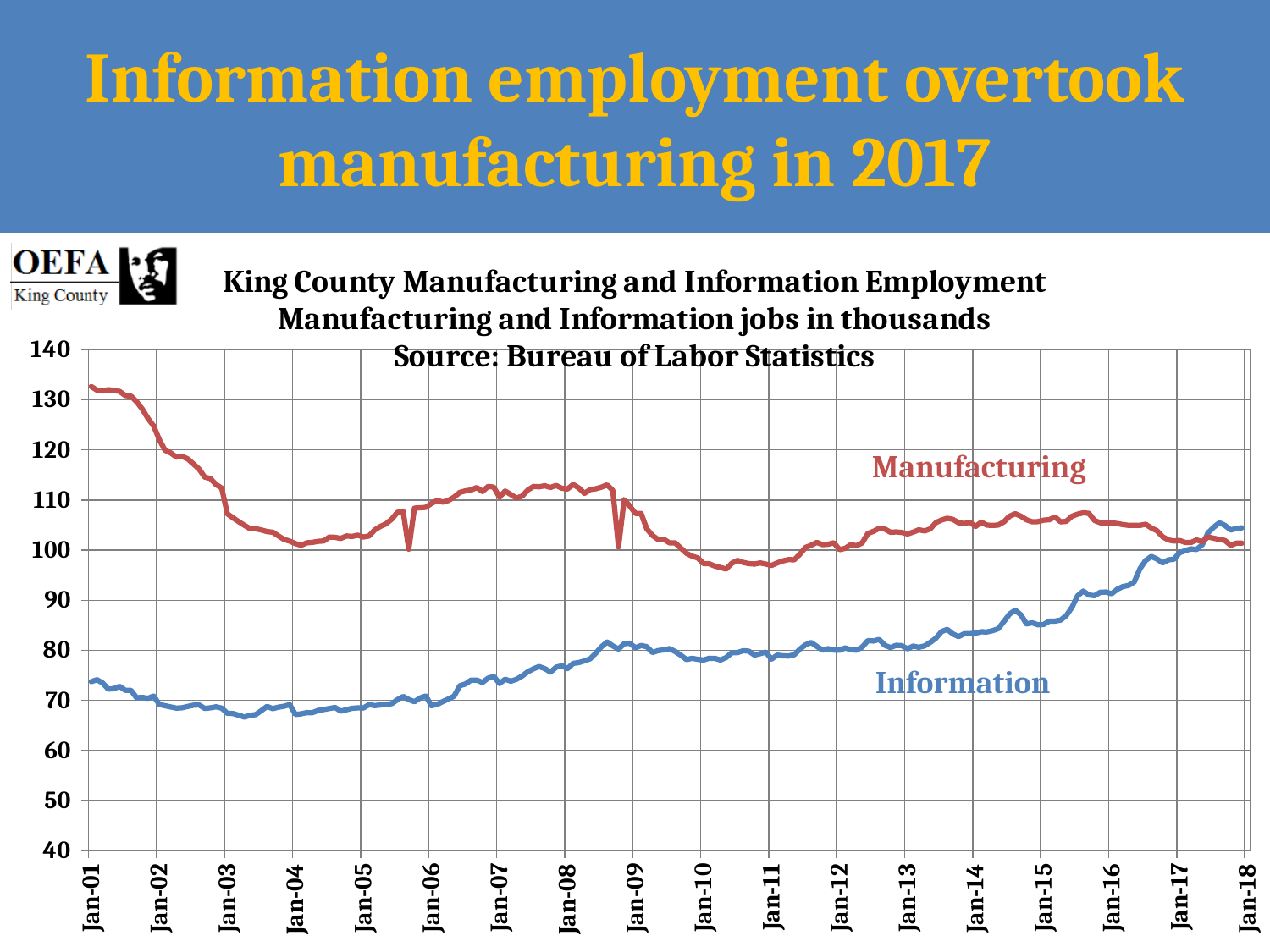
What is the title of the chart? King County Manufacturing and Information Employment Manufacturing and Information jobs in thousands Source: Bureau of Labor Statistics At Jan-01, which series has the higher value, Manufacturing or Information? Manufacturing How many year labels are shown on the x axis? 18 How many series are plotted on the chart? 2 Is the Manufacturing value at Jan-01 greater or less than 130? greater Does the Information line rise or fall between Jan-13 and Jan-18? rise What kind of chart is shown on the slide? line chart What are the names of the two series plotted on the chart? Manufacturing and Information Does the Manufacturing line rise or fall between Jan-01 and Jan-04? fall Is the Manufacturing value at Jan-11 greater or less than 100? less Is the Information value at Jan-01 greater or less than 80? less